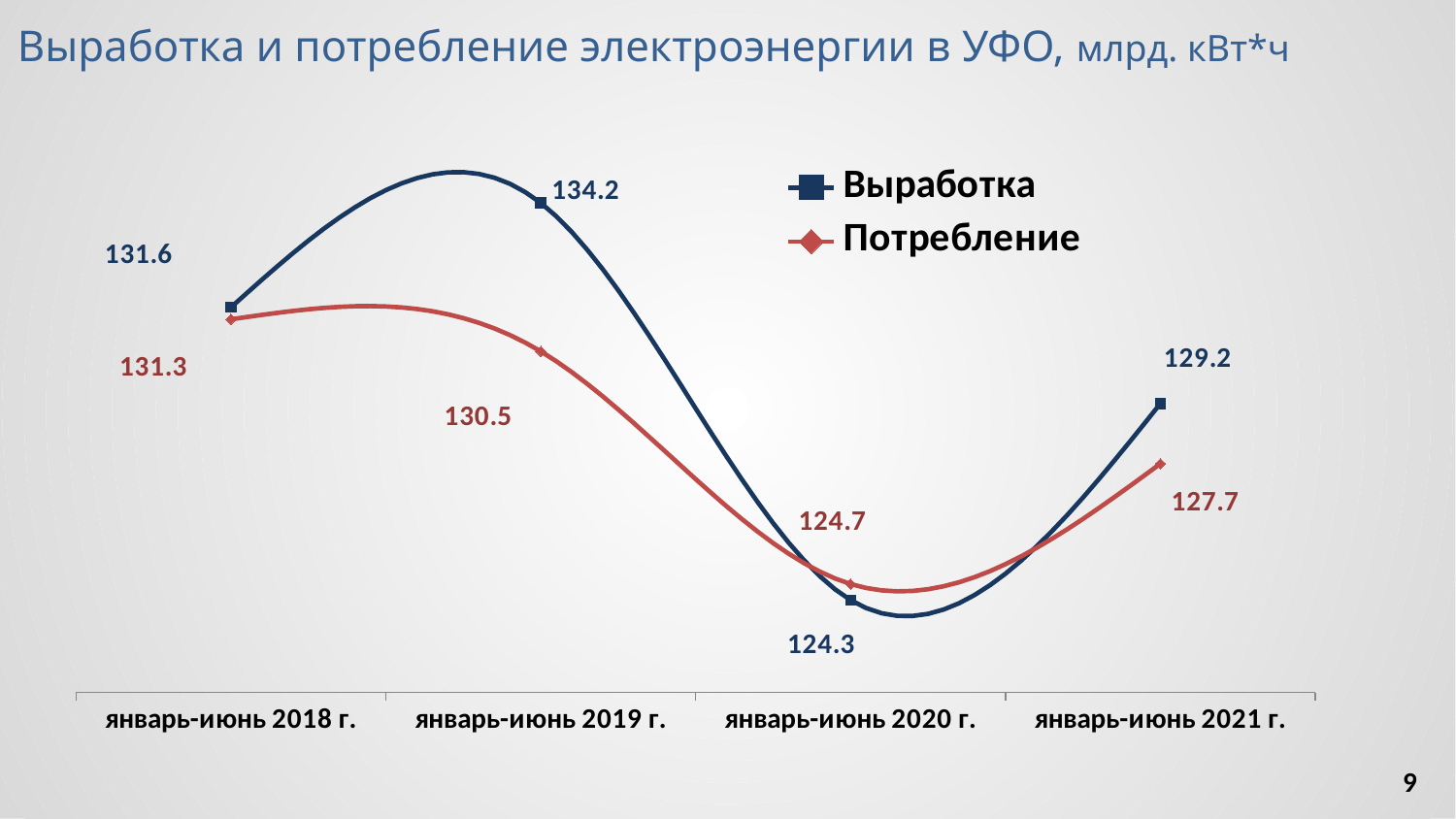
Does Выработка rise or fall from январь-июнь 2020 г. to январь-июнь 2021 г.? rise What is the value of Потребление for январь-июнь 2020 г.? 124.7 In which period is Выработка highest? январь-июнь 2019 г. Which is larger for январь-июнь 2020 г.: Выработка or Потребление? Потребление What is the difference between Выработка and Потребление for январь-июнь 2019 г.? 3.7 In which period is Потребление lowest? январь-июнь 2020 г. What is the value of Потребление for январь-июнь 2018 г.? 131.3 How many series does the legend list? 2 What is the value of Выработка for январь-июнь 2019 г.? 134.2 What type of chart is shown on the slide? line chart What is the value of Выработка for январь-июнь 2021 г.? 129.2 How many periods are shown on the x axis? 4